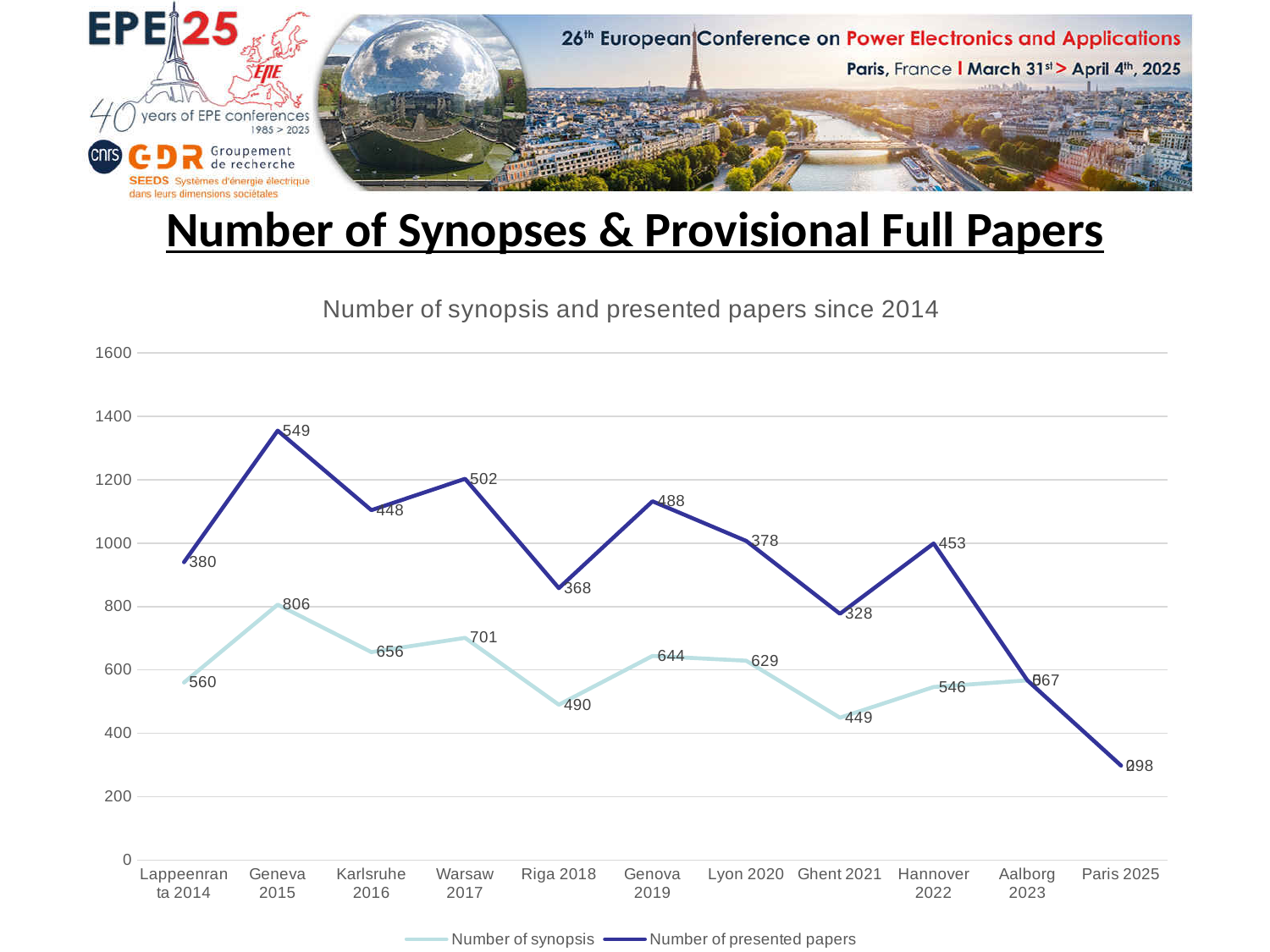
Which conference has the highest number of presented papers? Geneva 2015 What is the number of presented papers for Geneva 2015? 549 What is the difference in the number of synopsis between Geneva 2015 and Lappeenranta 2014? 246 How many conference locations are shown along the x axis? 11 What is the title of the chart? Number of synopsis and presented papers since 2014 Which conference has the highest number of synopsis? Geneva 2015 Which has more synopsis, Karlsruhe 2016 or Riga 2018? Karlsruhe 2016 What is the number of synopsis for Geneva 2015? 806 What kind of chart is shown on the slide? line chart What is the number of presented papers for Ghent 2021? 328 What is the number of synopsis for Riga 2018? 490 How many series does the legend list? 2